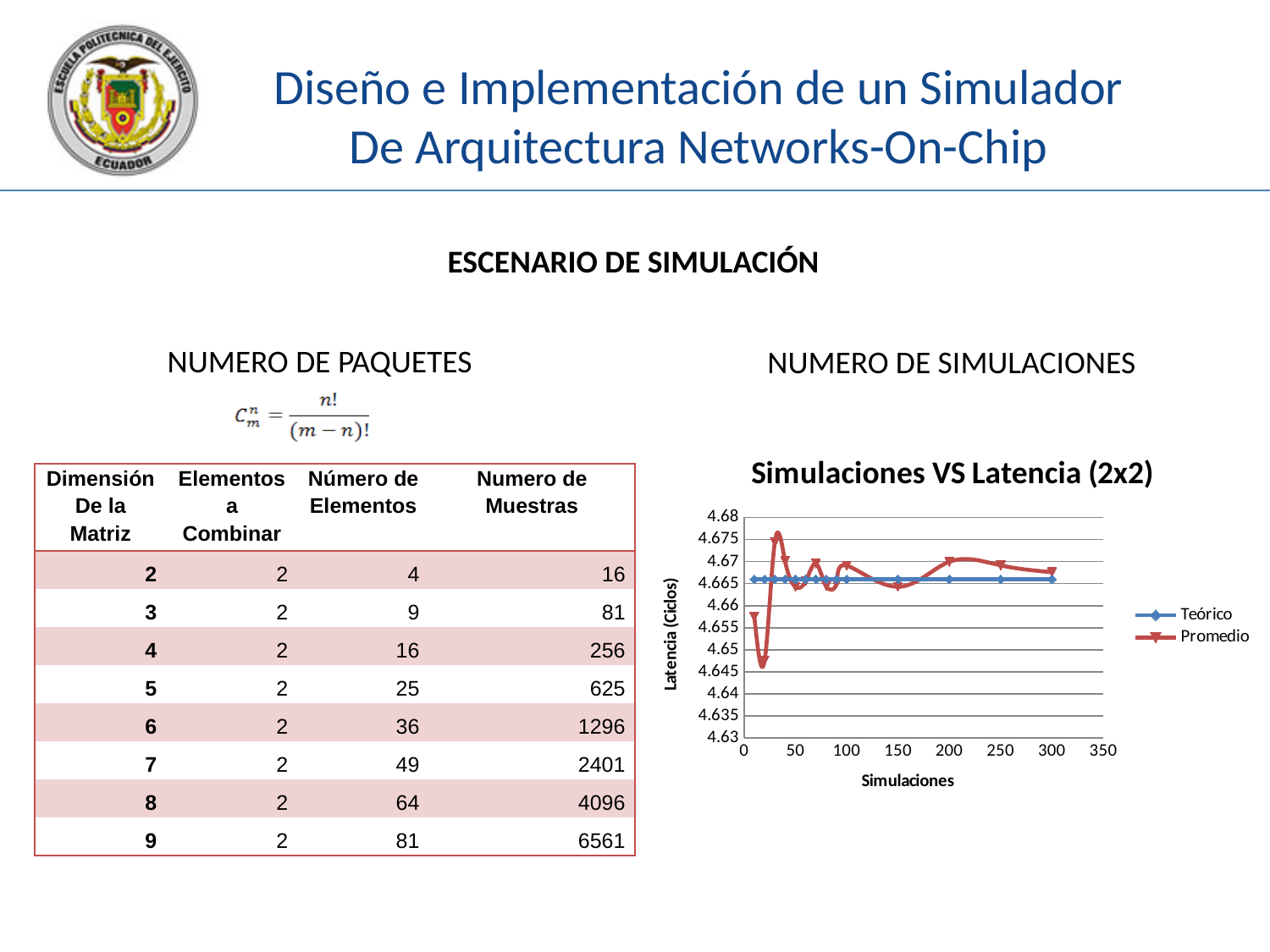
In the "Simulaciones VS Latencia (2x2)" chart, is the highest Promedio value greater or less than 4.67? greater How many series does the legend of the "Simulaciones VS Latencia (2x2)" chart list? 2 In the "Simulaciones VS Latencia (2x2)" chart, is the Teórico latency greater or less than 4.66? greater In the "Simulaciones VS Latencia (2x2)" chart, is the Teórico latency greater or less than 4.67? less In the "Simulaciones VS Latencia (2x2)" chart, which series has the larger value at around 20 simulations, Teórico or Promedio? Teórico What are the names of the two series in the "Simulaciones VS Latencia (2x2)" chart? Teórico and Promedio What kind of chart is "Simulaciones VS Latencia (2x2)"? line chart In the "Simulaciones VS Latencia (2x2)" chart, which series has the larger value at around 30 simulations, Teórico or Promedio? Promedio What is the y-axis title of the "Simulaciones VS Latencia (2x2)" chart? Latencia (Ciclos) In the "Simulaciones VS Latencia (2x2)" chart, which series shows the larger fluctuation across the simulations, Teórico or Promedio? Promedio In the "Simulaciones VS Latencia (2x2)" chart, does the Teórico series rise, fall, or stay flat as the number of simulations increases? stays flat